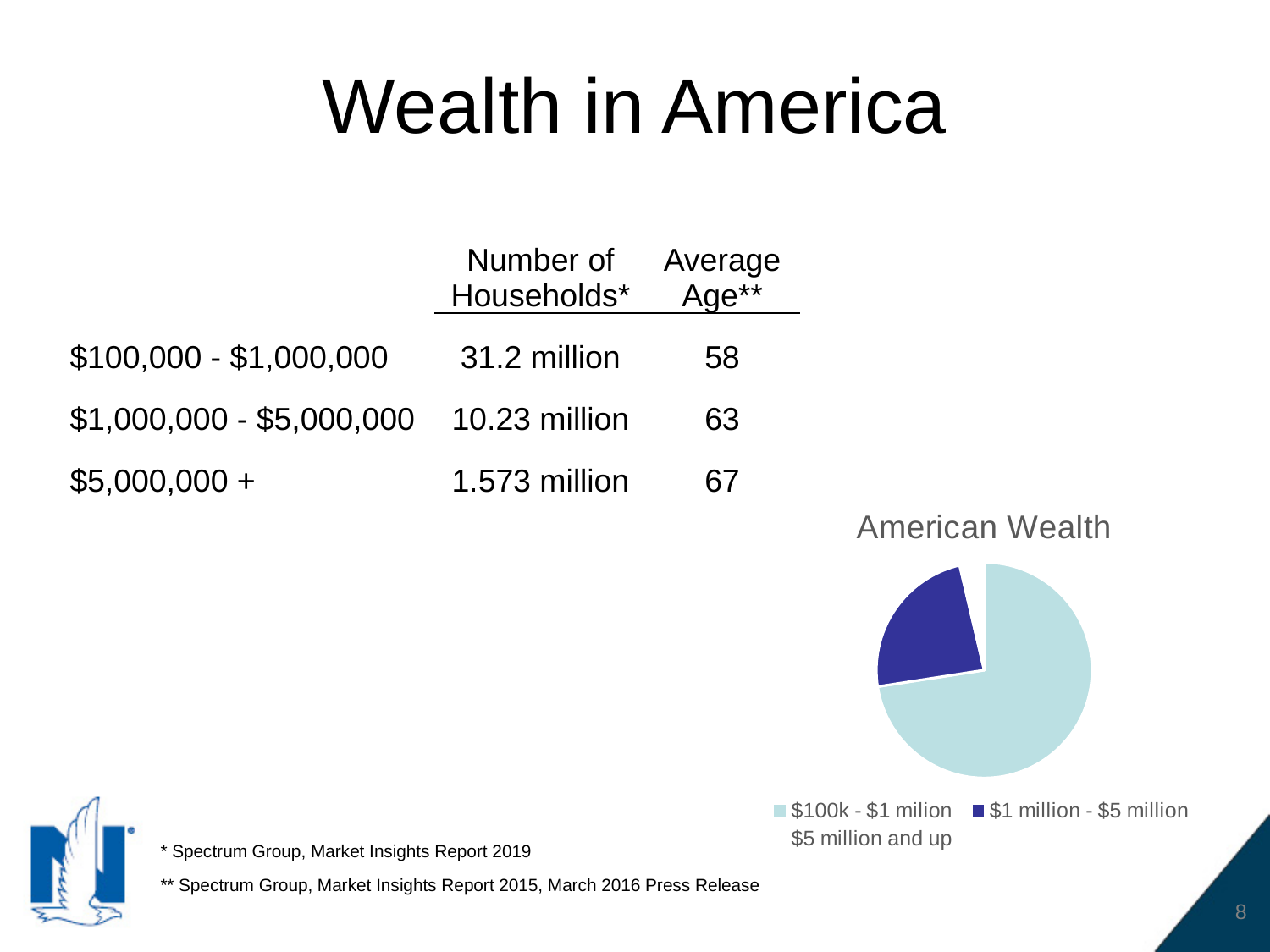
In the "American Wealth" pie chart, which category is shown in dark blue? $1 million - $5 million How many categories does the legend of the "American Wealth" pie chart list? 3 In the "American Wealth" pie chart, does the "$100k - $1 milion" slice take up more or less than half of the pie? more What kind of chart is the "American Wealth" chart? pie chart In the "American Wealth" pie chart, which slice is larger: "$100k - $1 milion" or "$1 million - $5 million"? $100k - $1 milion In the "American Wealth" pie chart, which category has the largest slice? $100k - $1 milion In the "American Wealth" pie chart, does the "$1 million - $5 million" slice take up more or less than half of the pie? less What is the title of the pie chart on the slide? American Wealth